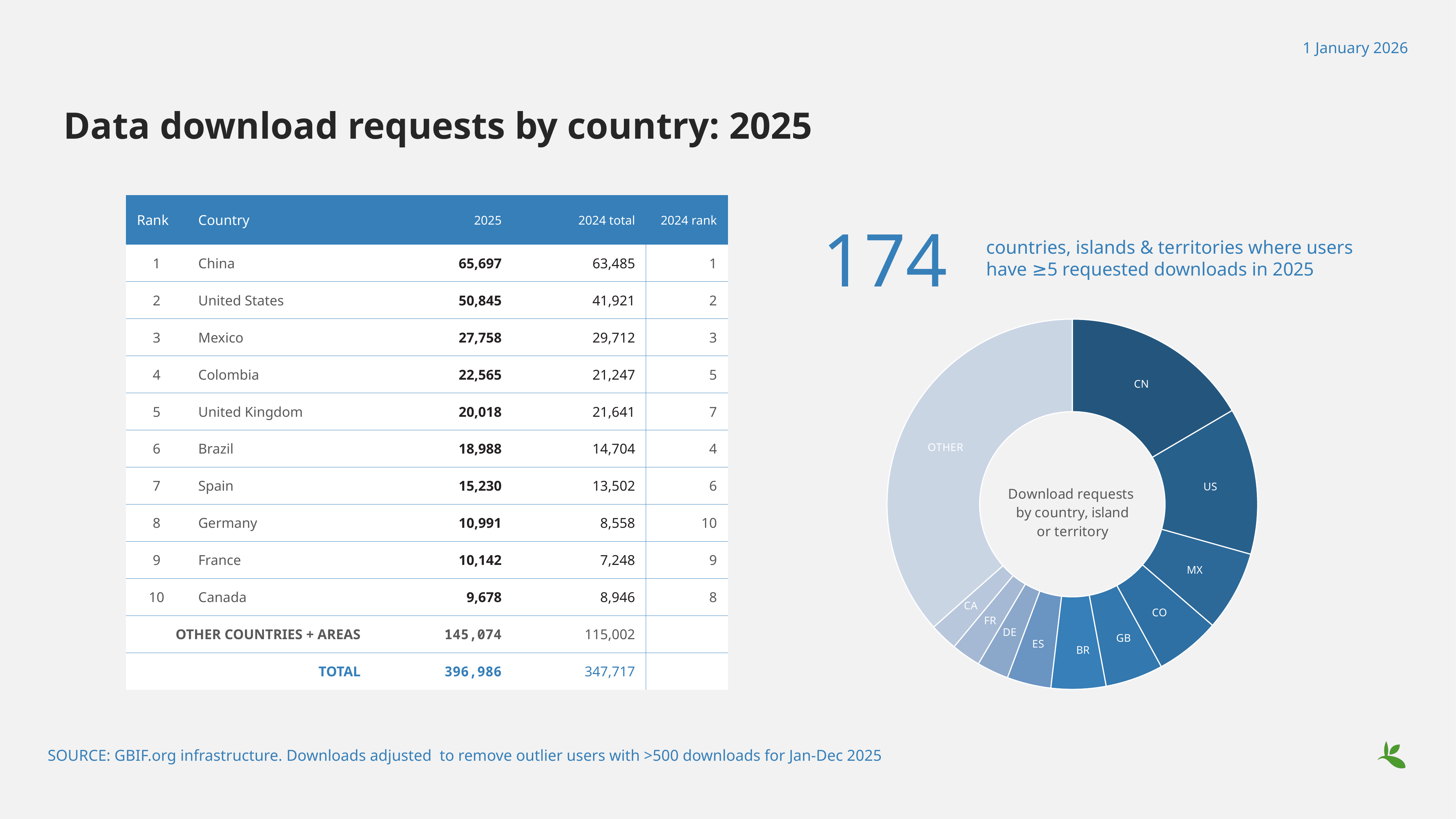
Which individual country slice in the donut chart is the largest? CN What text is printed in the centre of the donut chart? Download requests by country, island or territory What is the label of the lightest-coloured slice in the donut chart? OTHER What kind of chart is shown on the right of the slide? donut (pie) chart Which labelled slice of the donut chart is the smallest? CA In the donut chart, which slice is larger, MX or CO? MX What is the total number of download requests in 2025 shown in the table? 396,986 Which slice of the donut chart is the largest? OTHER What is the difference between China's and the United States' 2025 download requests? 14,852 In the donut chart, which slice is larger, CN or US? CN How many slices does the donut chart have? 11 According to the table, how many download requests did China have in 2025? 65,697